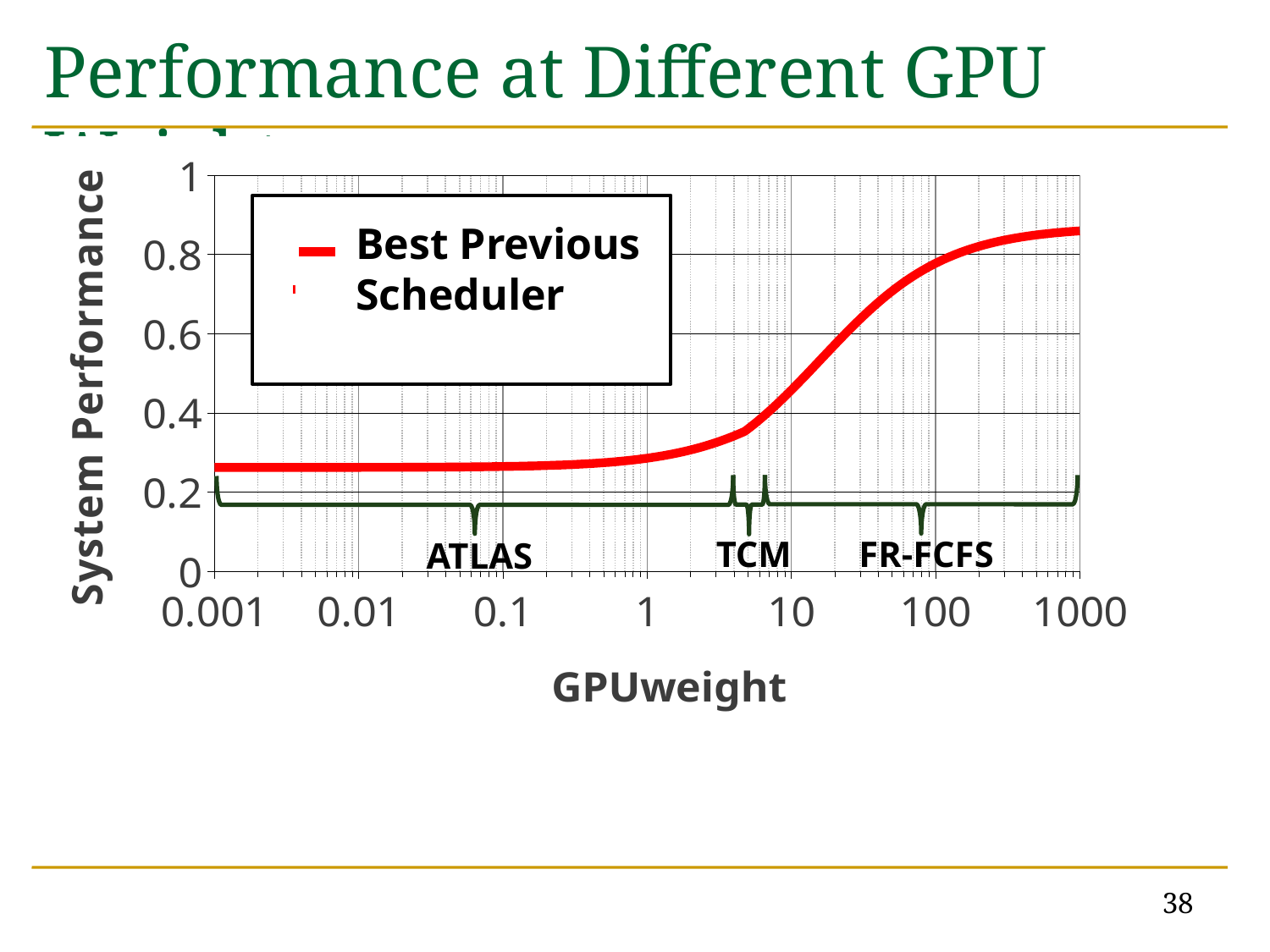
How many series does the legend list? 1 Which has the higher System Performance: GPUweight 0.001 or GPUweight 1000? GPUweight 1000 Is the System Performance value at GPUweight 1 greater or less than 0.4? less What kind of chart is shown on the slide? line chart Which has the lower System Performance: GPUweight 10 or GPUweight 100? GPUweight 10 Does System Performance rise or fall as GPUweight increases along the x axis? rise What is the name of the series shown in the legend? Best Previous Scheduler Is the System Performance value at GPUweight 0.001 greater or less than 0.4? less Is the System Performance value at GPUweight 1000 greater or less than 0.8? greater What is the label of the y axis? System Performance